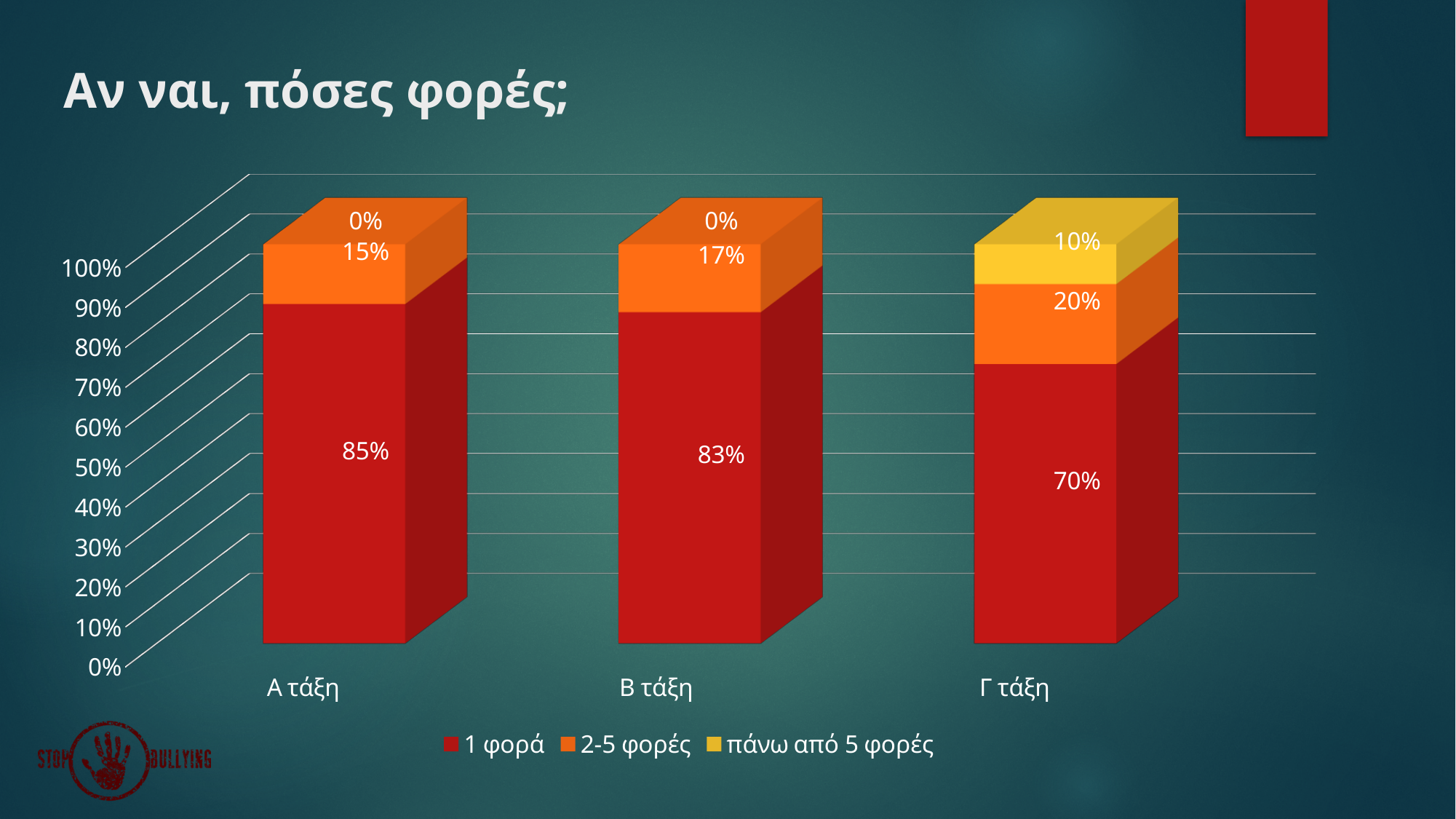
What is the value for "2-5 φορές" in Β τάξη? 17% What is the value for "πάνω από 5 φορές" in Α τάξη? 0% What is the value for "1 φορά" in Α τάξη? 85% What kind of chart is shown on the slide? Stacked bar chart Which class has the lowest value for "1 φορά"? Γ τάξη How many classes (categories) are shown on the x axis? 3 Which is larger: the "2-5 φορές" value for Β τάξη or for Γ τάξη? Γ τάξη What is the difference between the "1 φορά" values for Α τάξη and Γ τάξη? 15% Which class has the highest value for "1 φορά"? Α τάξη What is the value for "πάνω από 5 φορές" in Γ τάξη? 10% How many series does the legend list? 3 What is the title of the slide? Αν ναι, πόσες φορές;